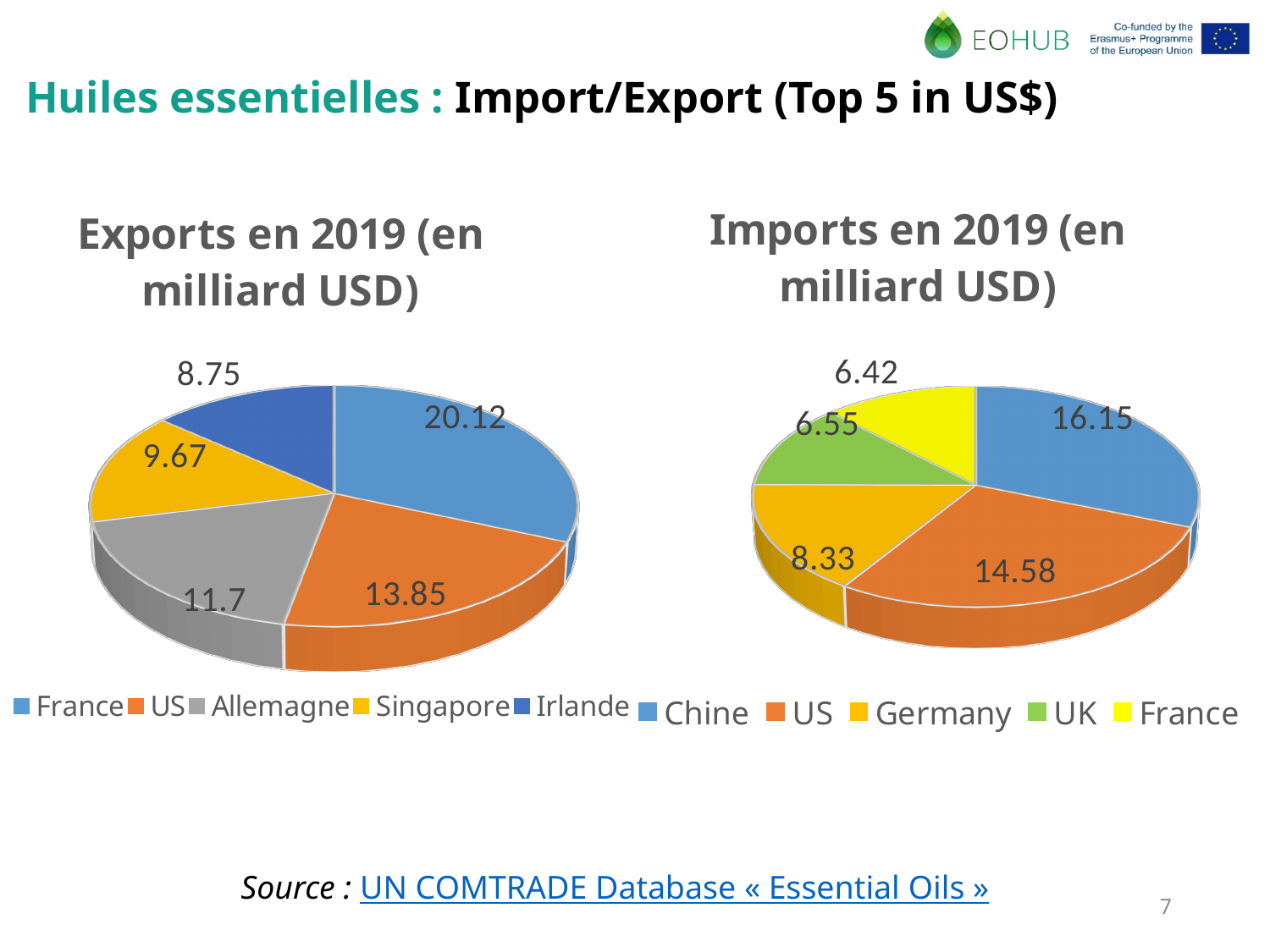
In the Imports en 2019 chart, what is the value for Germany? 8.33 What type of chart is the Exports en 2019 chart? Pie chart How many countries are shown in the Imports en 2019 chart? 5 In the Imports en 2019 chart, what is the difference between the values for Chine and US? 1.57 In the Exports en 2019 chart, what colour is the slice for Allemagne? Grey In the Imports en 2019 chart, which country has the largest slice? Chine In the Exports en 2019 chart, which country has the smallest slice? Irlande In the Exports en 2019 chart, which country has the largest slice? France In the Exports en 2019 chart, what is the value for France? 20.12 In the Imports en 2019 chart, what is the value for US? 14.58 In the Exports en 2019 chart, which is larger, the value for Singapore or the value for Irlande? Singapore In the Exports en 2019 chart, what is the difference between the values for France and Allemagne? 8.42